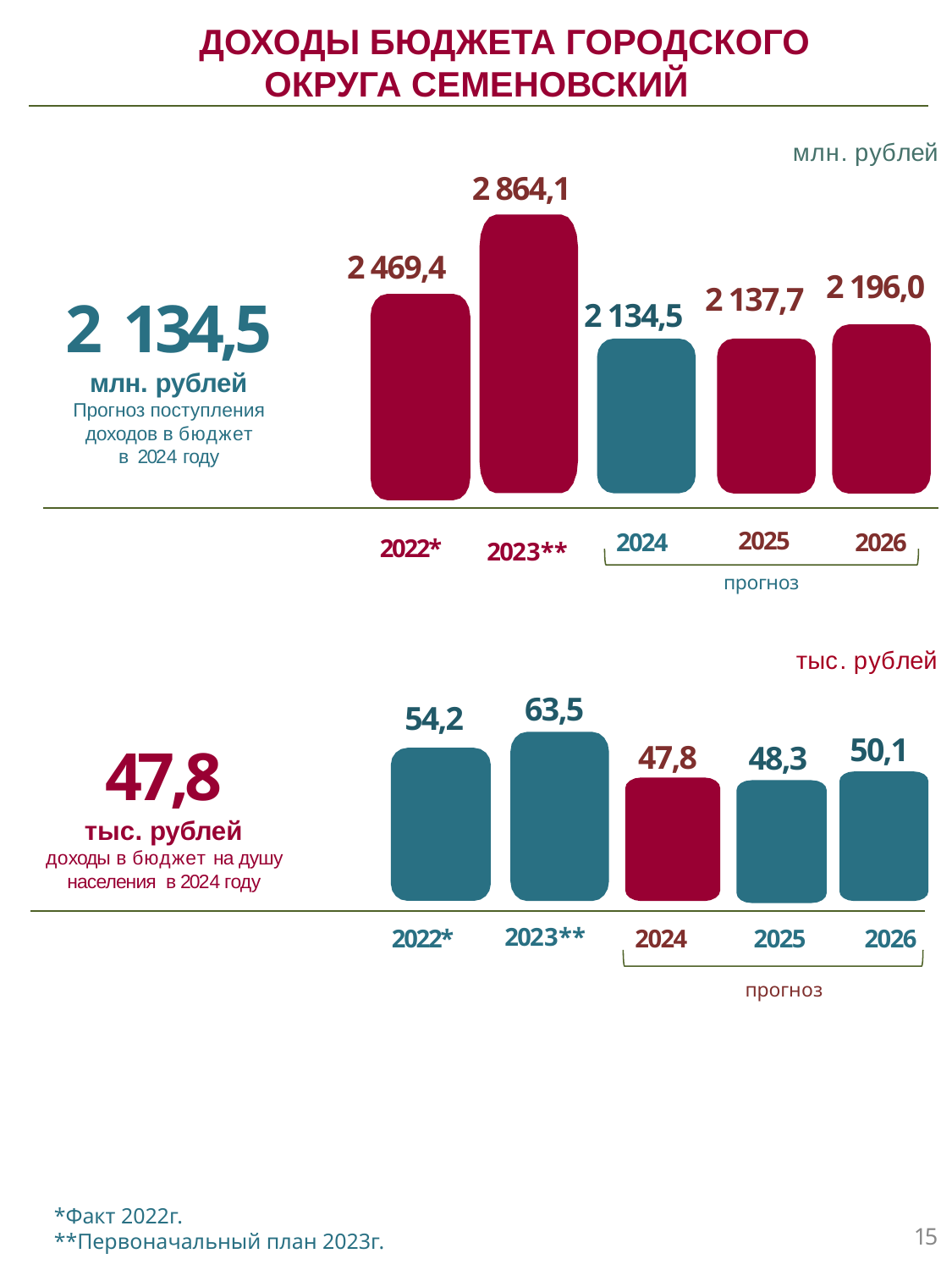
In the bottom chart (тыс. рублей), what is the value for 2025? 48,3 In the bottom chart (тыс. рублей), do the values rise or fall from 2024 to 2026? rise In the top chart (млн. рублей), what is the difference between the 2023** value and the 2022* value? 394,7 In the top chart (млн. рублей), what is the value for 2026? 2 196,0 In the bottom chart (тыс. рублей), which year has the lowest value? 2024 In the bottom chart (тыс. рублей), what is the difference between the 2026 value and the 2024 value? 2,3 In the top chart (млн. рублей), which year has the highest value? 2023** What type of chart is the bottom chart (тыс. рублей)? bar chart In the top chart (млн. рублей), how many bars are shown? 5 In the top chart (млн. рублей), which year has the lowest value? 2024 In the bottom chart (тыс. рублей), which is larger, the value for 2022* or the value for 2023**? 2023** In the top chart (млн. рублей), what is the value for 2023**? 2 864,1